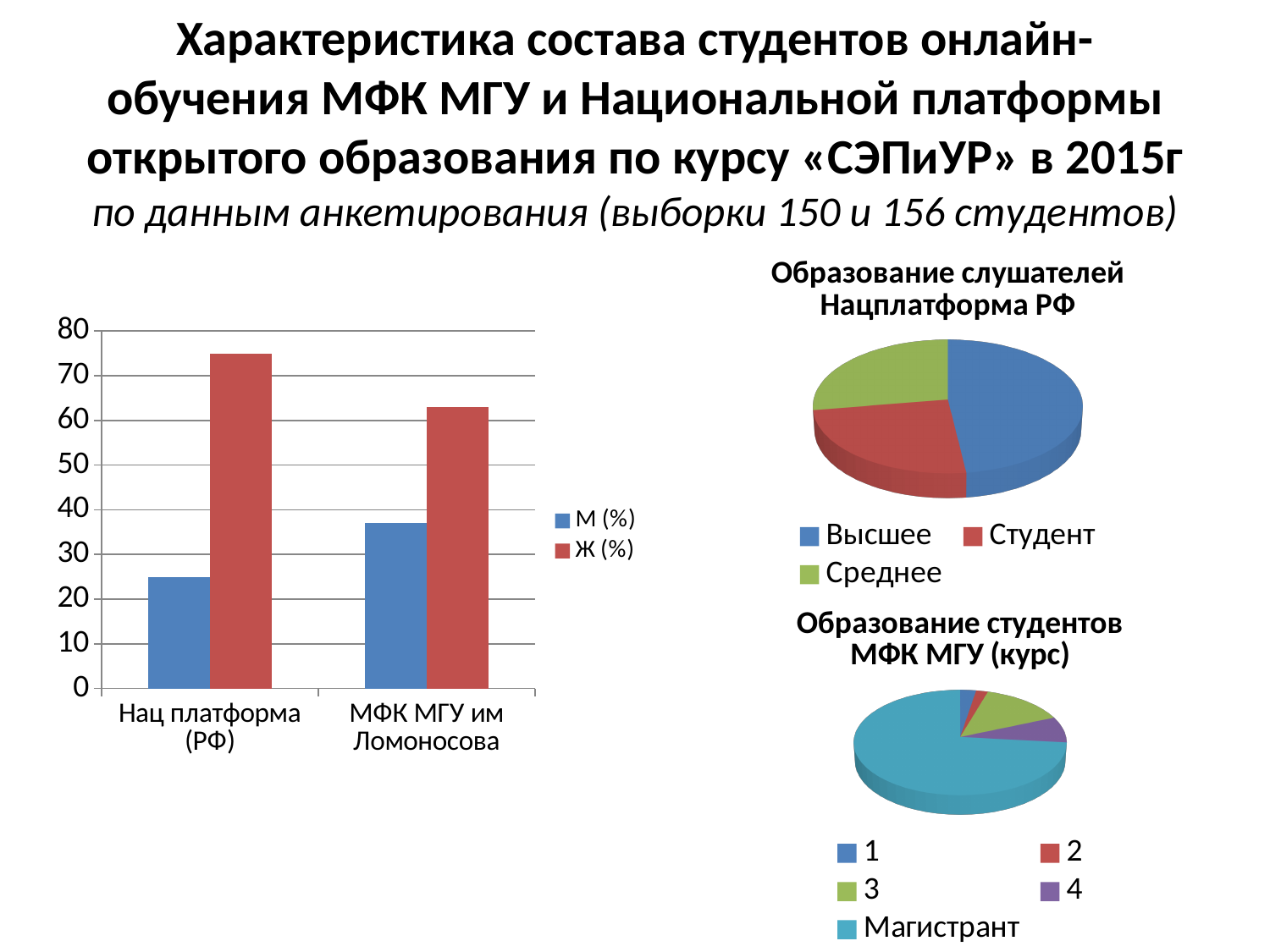
In the bar chart on the left, is the value of М (%) for МФК МГУ им Ломоносова greater or less than 30? greater What kind of chart is the chart titled "Образование слушателей Нацплатформа РФ"? pie chart In the bar chart on the left, how many series does the legend list? 2 In the pie chart titled "Образование слушателей Нацплатформа РФ", which category has the largest slice? Высшее In the bar chart on the left, how many categories are shown on the x axis? 2 In the pie chart titled "Образование студентов МФК МГУ (курс)", which category has the largest slice? Магистрант How many entries does the legend of the pie chart titled "Образование студентов МФК МГУ (курс)" list? 5 In the bar chart on the left, is the value of Ж (%) for Нац платформа (РФ) greater or less than 70? greater What kind of chart is the chart on the left side of the slide? bar chart In the bar chart on the left, which series has the larger value for МФК МГУ им Ломоносова, М (%) or Ж (%)? Ж (%) In the bar chart on the left, is the value of М (%) for Нац платформа (РФ) greater or less than 30? less In the bar chart on the left, which category has the higher value for М (%)? МФК МГУ им Ломоносова